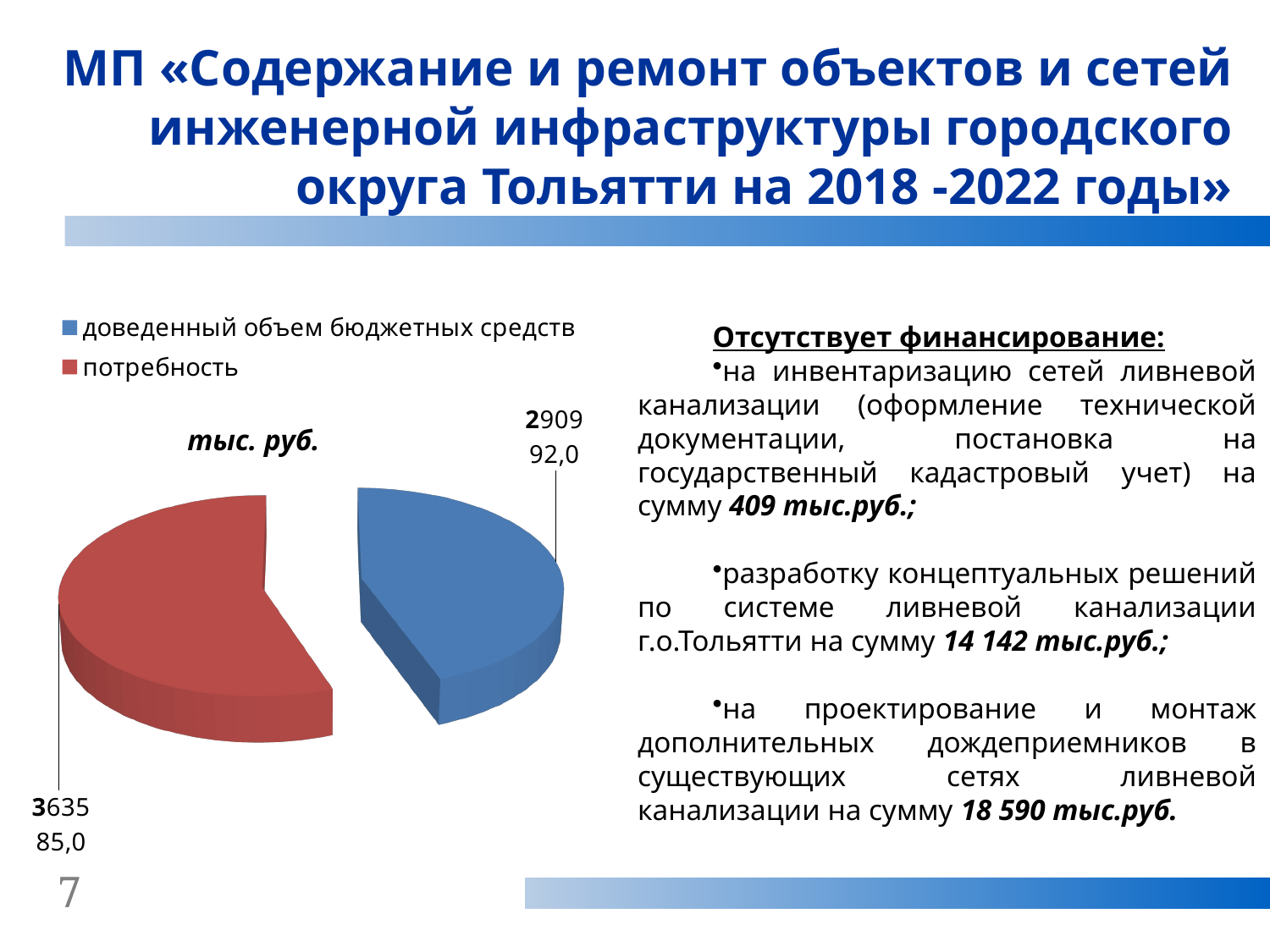
Which category has the smallest share of the pie chart? доведенный объем бюджетных средств What colour is the 'потребность' slice in the pie chart? red How many entries does the legend of the pie chart list? 2 Which slice of the pie chart is larger: 'доведенный объем бюджетных средств' or 'потребность'? потребность What unit label is shown next to the pie chart? тыс. руб. How many slices does the pie chart have? 2 Which category has the largest share of the pie chart? потребность What kind of chart is shown on the slide? pie chart